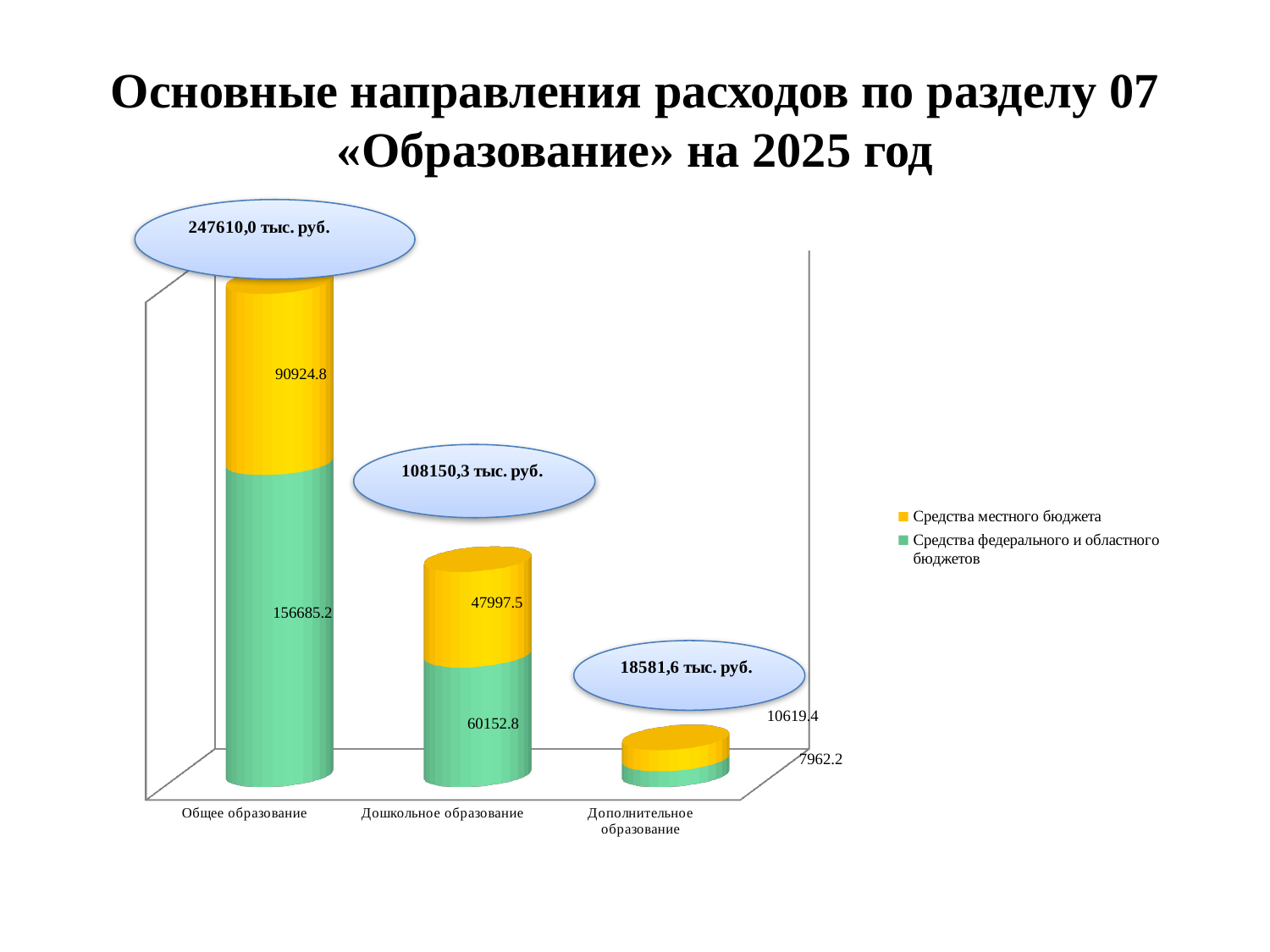
For Дополнительное образование, which is larger: Средства местного бюджета or Средства федерального и областного бюджетов? Средства местного бюджета How many categories are shown on the x axis of the chart? 3 What kind of chart is shown on the slide? Stacked bar chart Which category has the highest total expenditure? Общее образование What is the value of Средства местного бюджета for Общее образование? 90924.8 What is the total shown for the Дошкольное образование bar? 108150,3 тыс. руб. What is the value of Средства федерального и областного бюджетов for Дополнительное образование? 7962.2 What is the value of Средства федерального и областного бюджетов for Общее образование? 156685.2 What is the value of Средства местного бюджета for Дошкольное образование? 47997.5 Which category has the lowest total expenditure? Дополнительное образование What is the difference between Средства федерального и областного бюджетов and Средства местного бюджета for Дошкольное образование? 12155.3 How many series does the chart legend list? 2